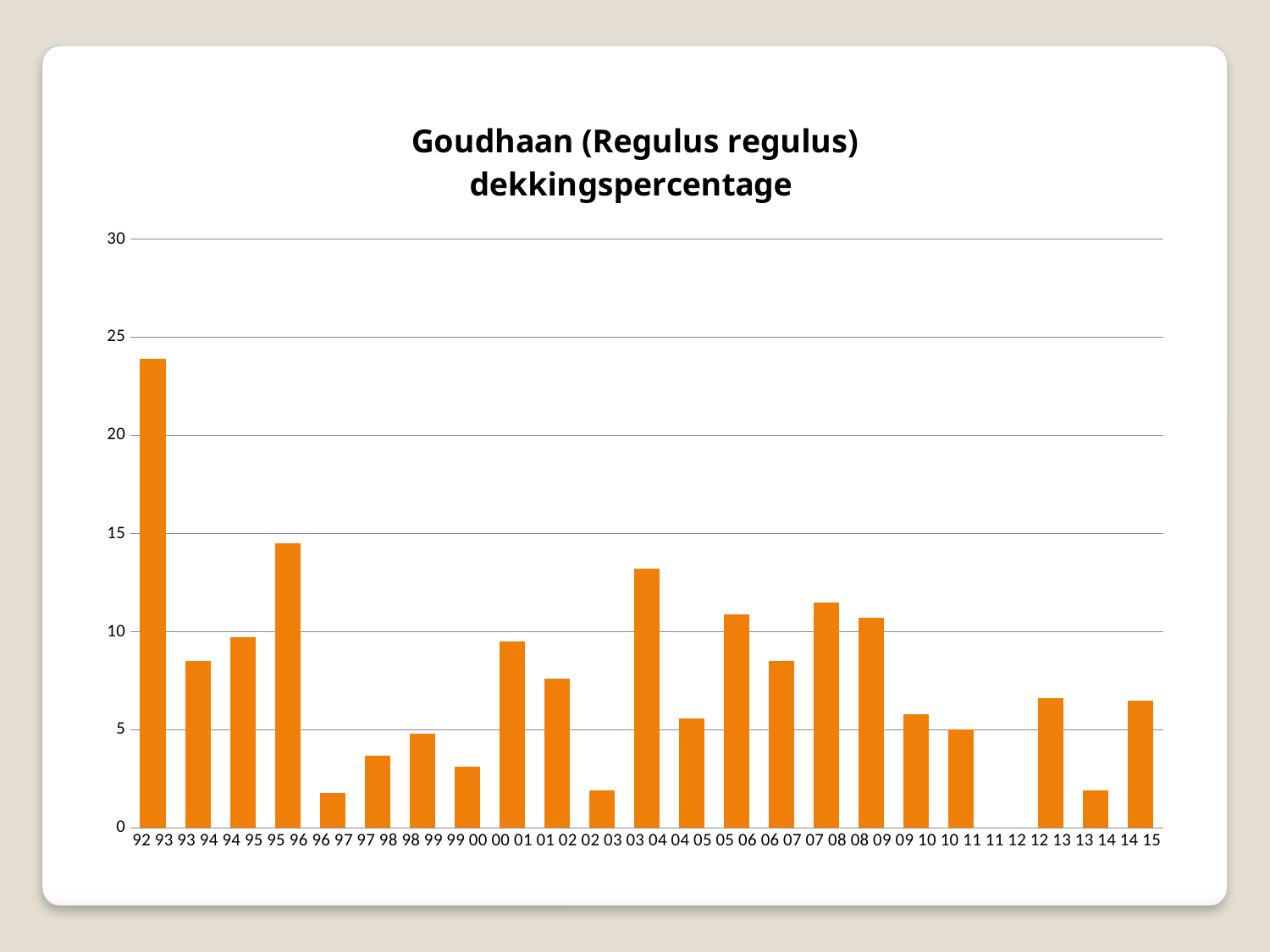
What is the title of the chart? Goudhaan (Regulus regulus) dekkingspercentage Is the value for 92 93 greater or less than 20? greater From 07 08 to 10 11, do the values rise or fall? fall Is the value for 12 13 greater or less than 5? greater What kind of chart is shown on the slide? bar chart Which is larger, the value for 05 06 or the value for 06 07? 05 06 Which is larger, the value for 03 04 or the value for 07 08? 03 04 Which category has the highest value? 92 93 Is the value for 96 97 greater or less than 5? less Which category has no visible bar (the lowest value)? 11 12 How many categories are shown on the x axis? 23